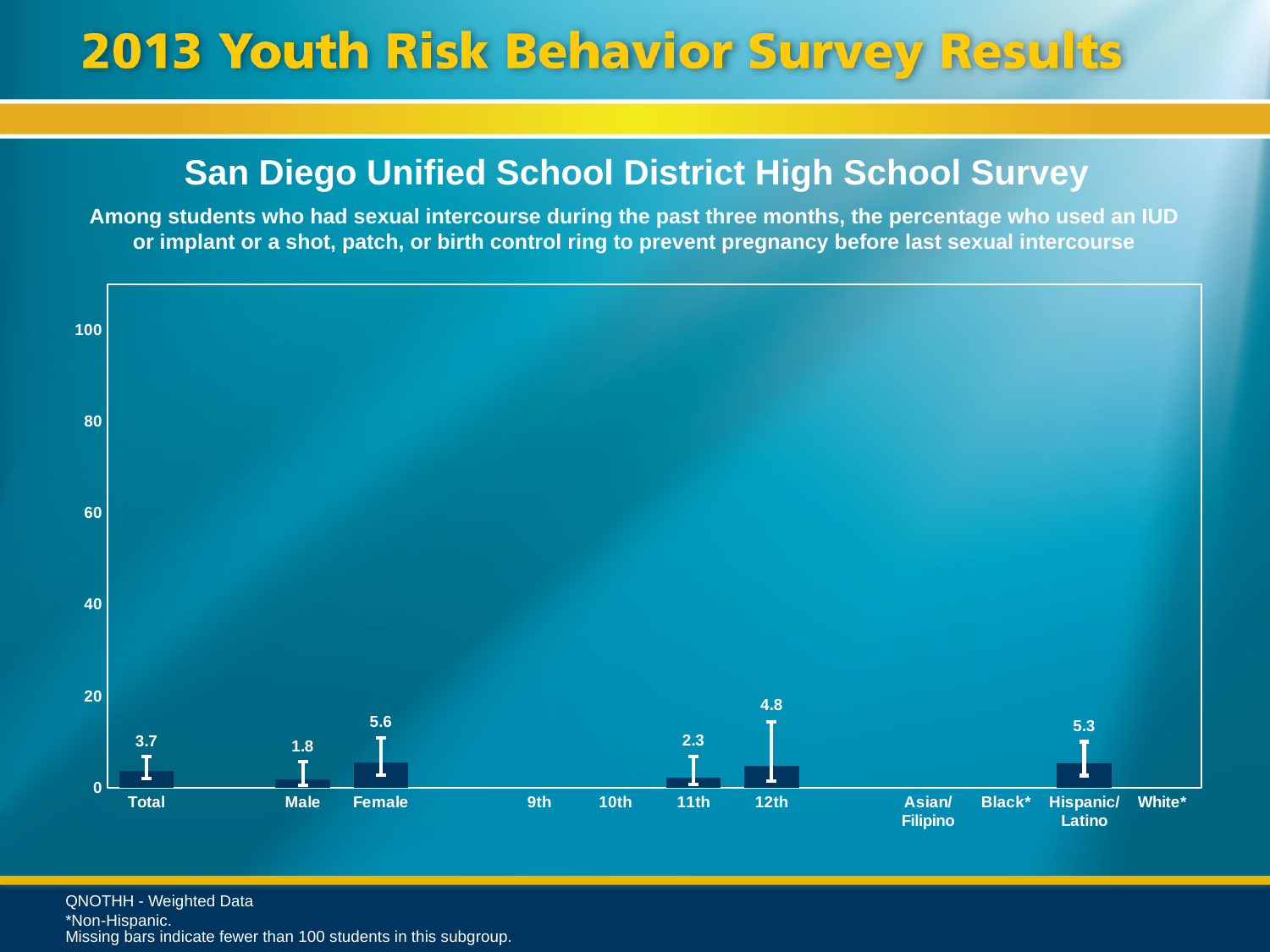
What is the value for Female? 5.6 Which category has the lowest value among the bars shown? Male Which category has the highest value among the bars shown? Female What is the difference between the Female and Male values? 3.8 What is the value for Total? 3.7 How many bars are plotted on the chart? 6 What kind of chart is shown? bar chart What is the value for Hispanic/Latino? 5.3 Is the value for Female greater or less than 20? less What is the highest value shown on the y axis? 100 What is the value for 12th grade? 4.8 Which is larger, the value for 11th grade or 12th grade? 12th